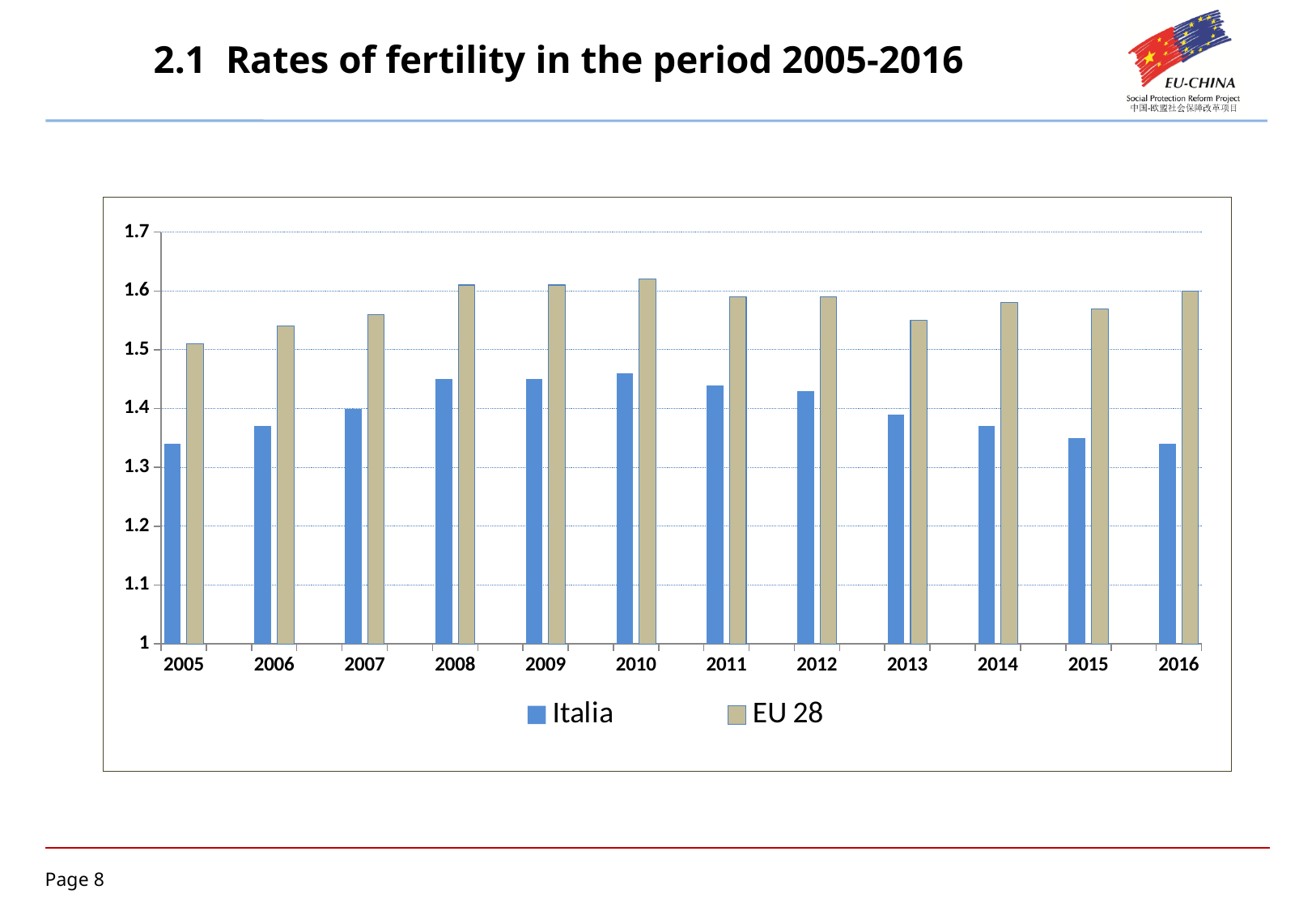
Which series is shown with blue bars? Italia In 2010, which series has the higher value, Italia or EU 28? EU 28 Is the EU 28 value for 2013 greater or less than 1.6? less How many series does the legend list? 2 For Italia, which year has the higher value, 2005 or 2010? 2010 Is the Italia value for 2005 greater or less than 1.4? less In which year is the EU 28 value lowest? 2005 How many years are shown along the x axis? 12 Is the EU 28 value for 2010 greater or less than 1.6? greater What kind of chart is shown on the slide? Bar chart Do the Italia values rise or fall from 2010 to 2016? fall